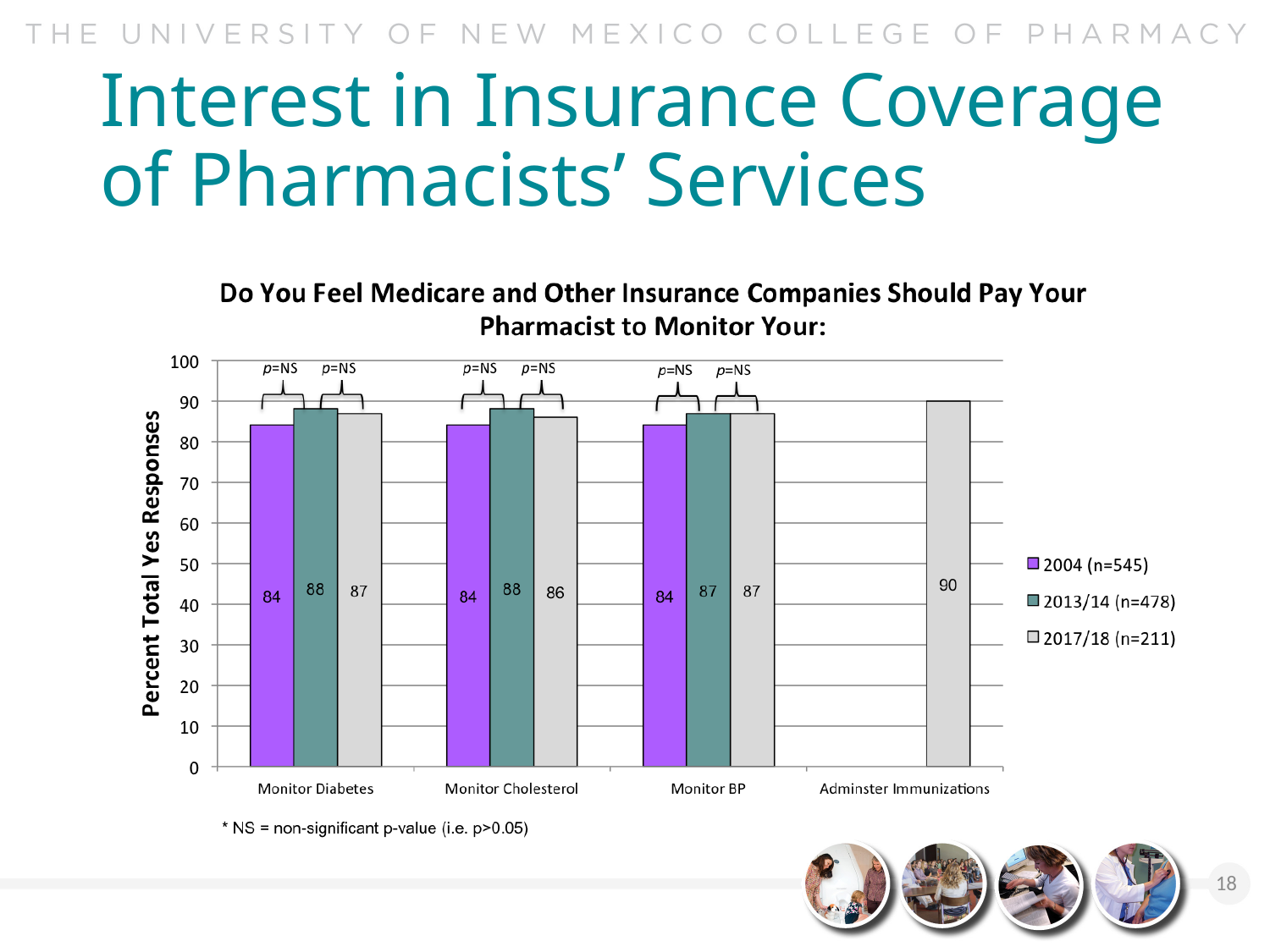
What is the value for 2004 (n=545) in the Monitor Diabetes category? 84 What is the value for 2017/18 (n=211) in the Monitor BP category? 87 Which series is shown in purple? 2004 (n=545) Which is larger for Monitor Cholesterol: the 2013/14 (n=478) value or the 2017/18 (n=211) value? 2013/14 (n=478) How many series does the legend list? 3 What is the label of the y axis? Percent Total Yes Responses What is the difference between the 2013/14 (n=478) and 2004 (n=545) values for Monitor Diabetes? 4 What is the value for 2013/14 (n=478) in the Monitor Cholesterol category? 88 How many categories are shown on the x axis? 4 What is the value for 2017/18 (n=211) in the Adminster Immunizations category? 90 Which category has the highest value for the 2017/18 (n=211) series? Adminster Immunizations What kind of chart is shown on the slide? bar chart